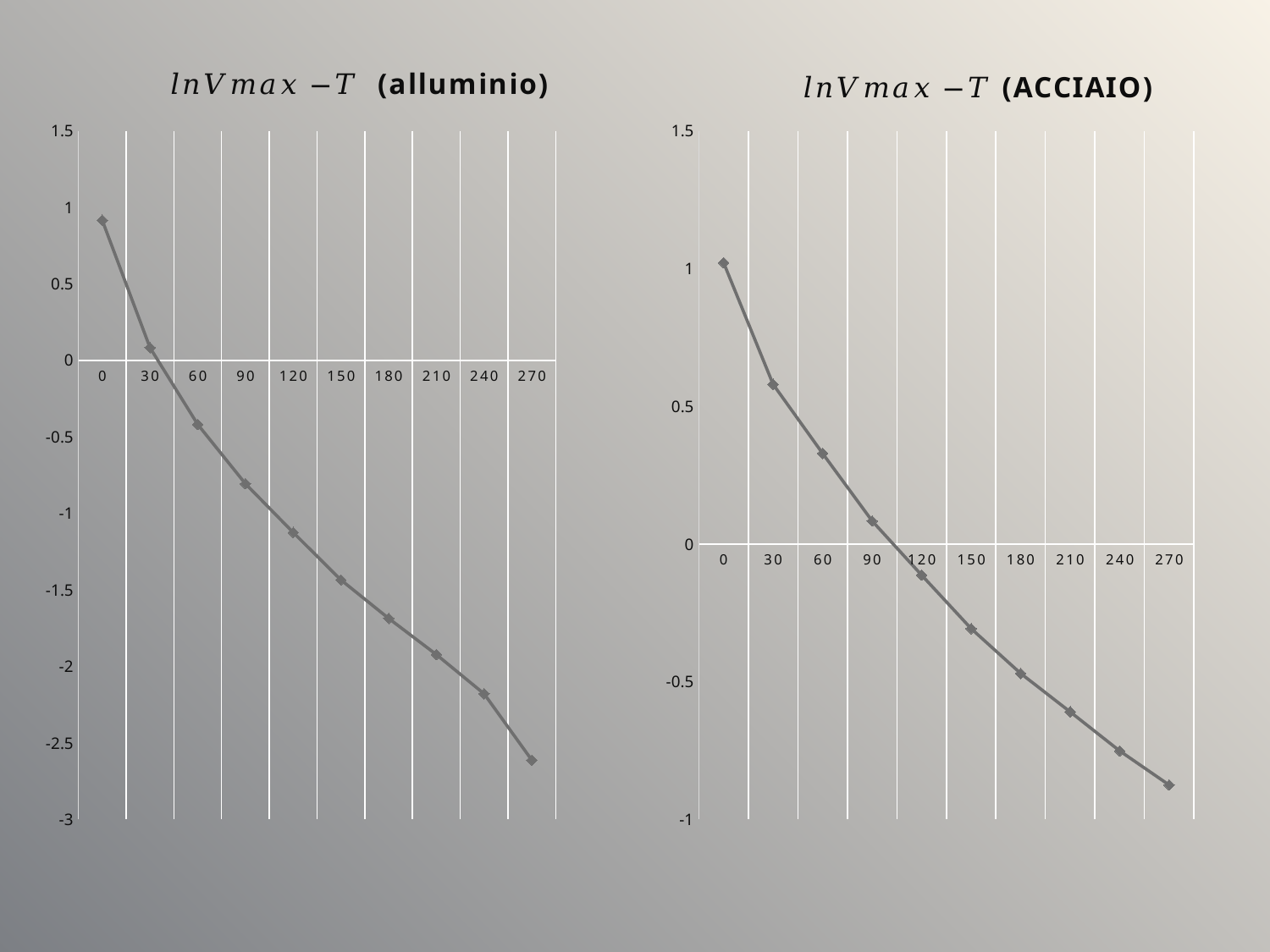
In the lnVmax −T (ACCIAIO) chart, do the values rise or fall as T increases along the x axis? fall In the lnVmax −T (alluminio) chart, is the value at T = 0 greater or less than 0.5? greater In the lnVmax −T (alluminio) chart, at which T value is the plotted value highest? 0 In the lnVmax −T (ACCIAIO) chart, at which T value is the plotted value lowest? 270 In the lnVmax −T (alluminio) chart, do the values rise or fall as T increases along the x axis? fall In the lnVmax −T (ACCIAIO) chart, is the value at T = 270 greater or less than -0.5? less At T = 270, which chart shows the larger value, lnVmax −T (alluminio) or lnVmax −T (ACCIAIO)? lnVmax −T (ACCIAIO) How many data points are plotted in the lnVmax −T (ACCIAIO) chart? 10 In the lnVmax −T (alluminio) chart, is the value at T = 270 greater or less than -2? less What is the lowest value shown on the y axis of the lnVmax −T (alluminio) chart? -3 What kind of chart is the lnVmax −T (alluminio) chart? line chart